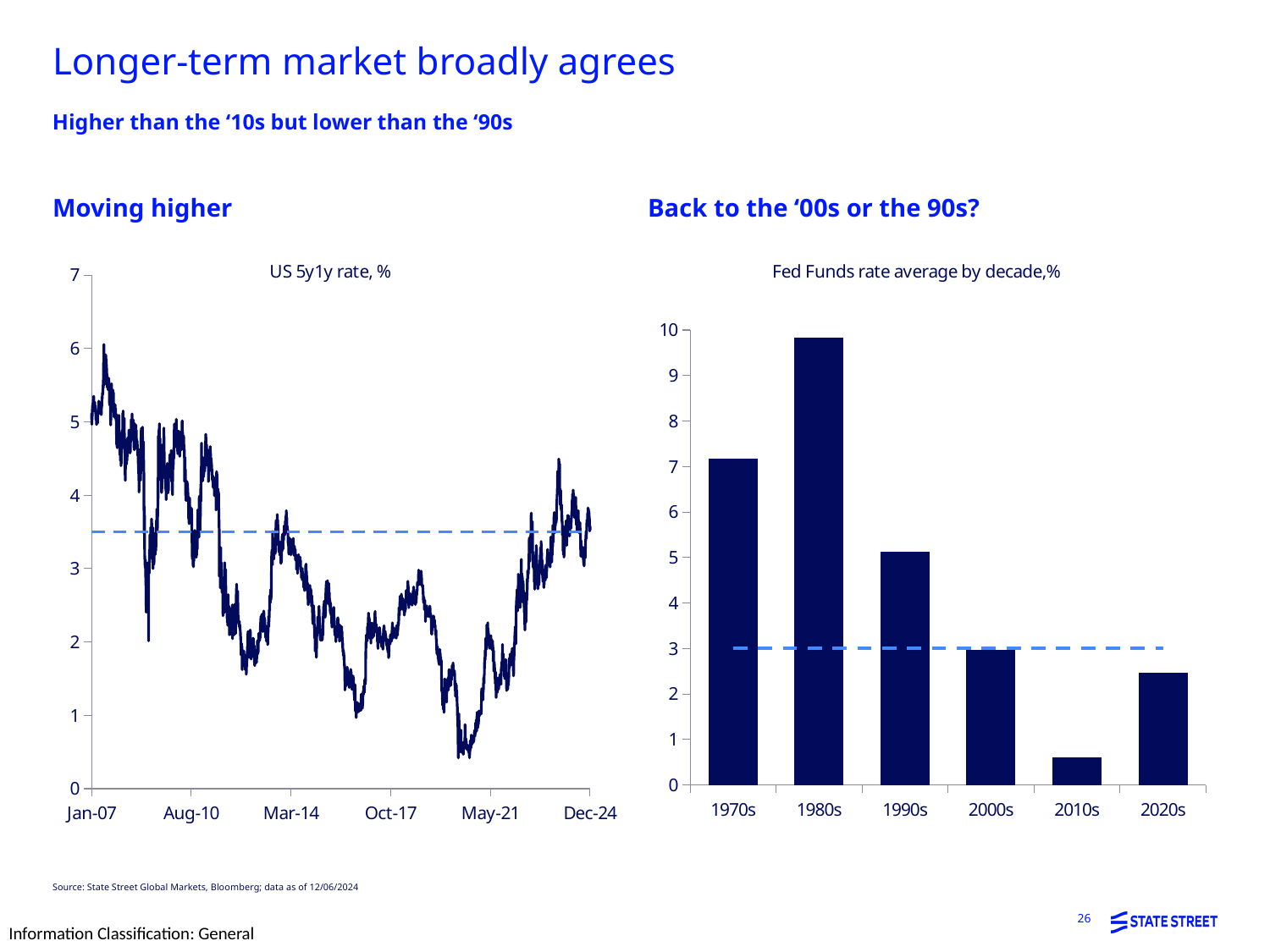
In the 'Fed Funds rate average by decade,%' chart, is the value for the 2010s greater or less than 1? less In the 'Fed Funds rate average by decade,%' chart, which decade has the highest average rate? 1980s In the 'Fed Funds rate average by decade,%' chart, which is larger, the 1990s or the 2000s? 1990s How many decades are shown in the 'Fed Funds rate average by decade,%' chart? 6 In the 'Fed Funds rate average by decade,%' chart, which decade has the lowest average rate? 2010s What kind of chart is the 'Fed Funds rate average by decade,%' chart? bar chart What is the title of the chart on the right side of the slide? Fed Funds rate average by decade,% In the 'Fed Funds rate average by decade,%' chart, is the value for the 1980s greater or less than 9? greater What kind of chart is the 'US 5y1y rate, %' chart? line chart In the 'US 5y1y rate, %' chart, is the value at Jan-07 greater or less than 4? greater